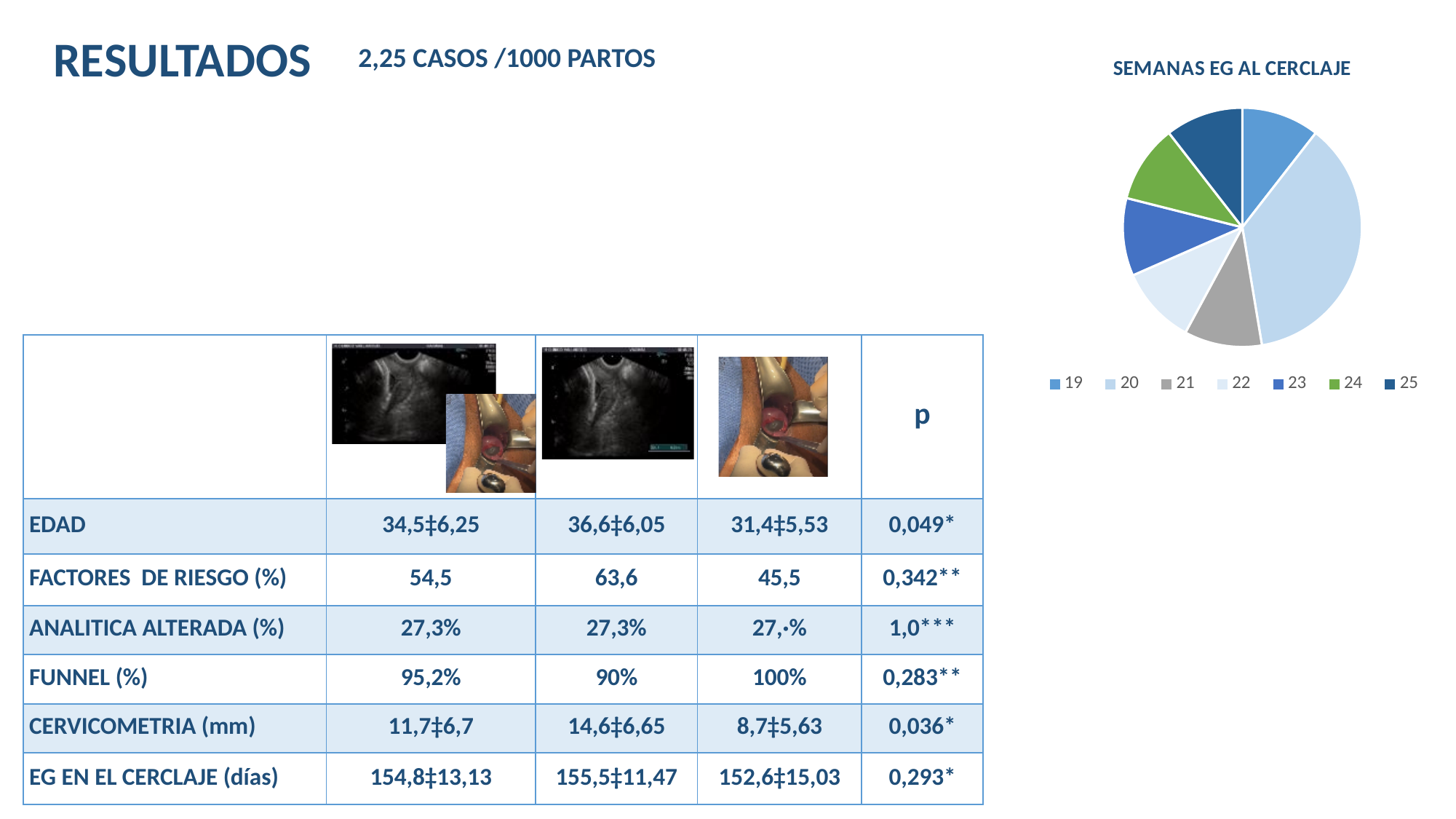
What is the first category listed in the pie chart legend? 19 In the pie chart, which slice is larger: 20 or 23? 20 In the pie chart, which slice is larger: 25 or 20? 20 In the pie chart, which slice is larger: 20 or 21? 20 What is the title of the pie chart? SEMANAS EG AL CERCLAJE How many categories (slices) does the pie chart have? 7 What colour is the slice for category 24 in the pie chart? green What kind of chart is shown on the slide? pie chart Which category has the largest slice in the pie chart? 20 How many entries does the legend of the pie chart list? 7